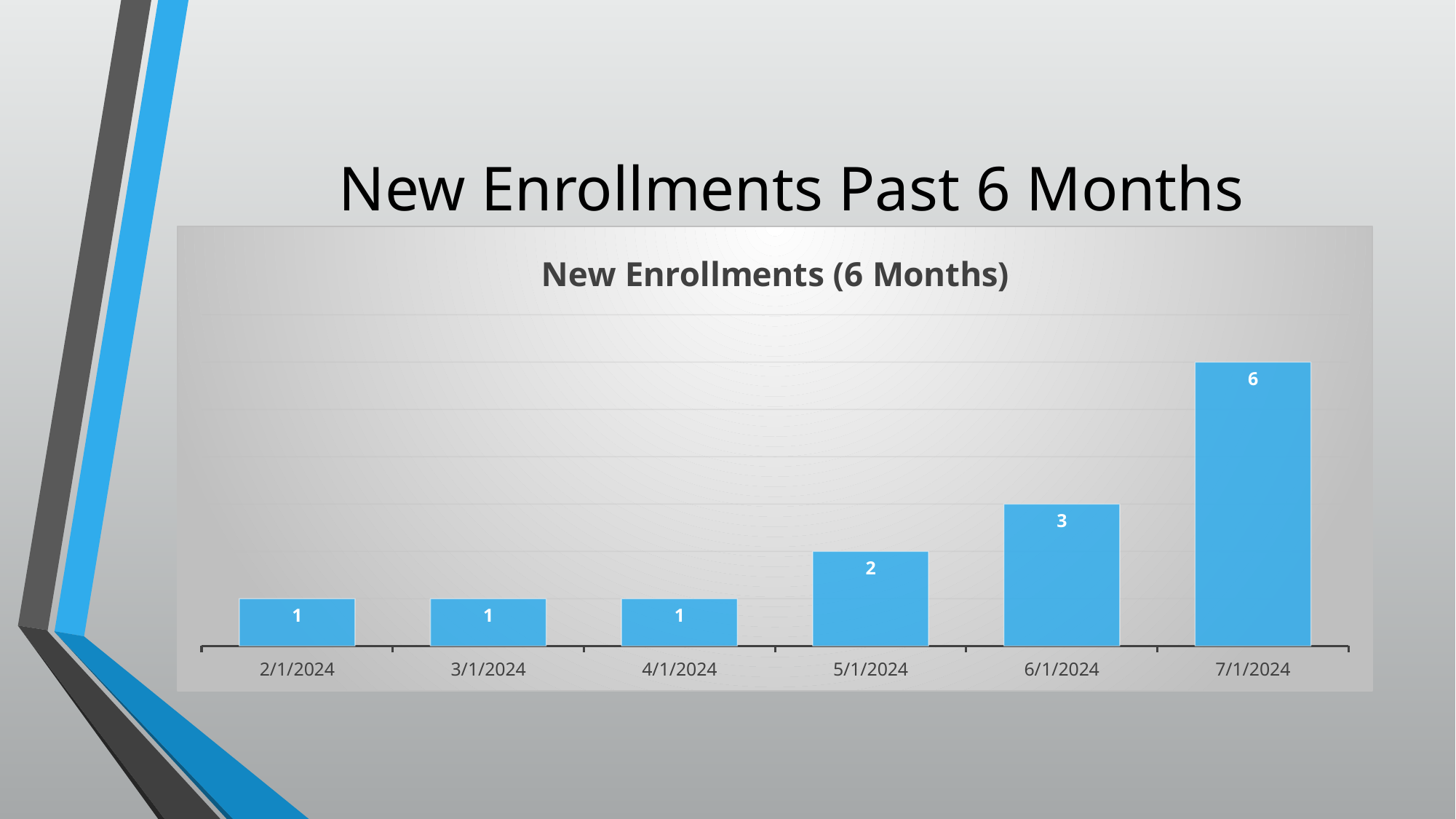
What kind of chart is shown? bar chart Which is larger, the value for 6/1/2024 or the value for 5/1/2024? 6/1/2024 What is the difference between the values for 5/1/2024 and 4/1/2024? 1 Do the values rise or fall from 2/1/2024 to 7/1/2024? rise What is the value for 7/1/2024? 6 Which date has the highest value? 7/1/2024 What is the title of the chart? New Enrollments (6 Months) What is the value for 6/1/2024? 3 What is the value for 5/1/2024? 2 What is the difference between the values for 7/1/2024 and 6/1/2024? 3 How many dates are shown on the x axis? 6 What is the value for 2/1/2024? 1